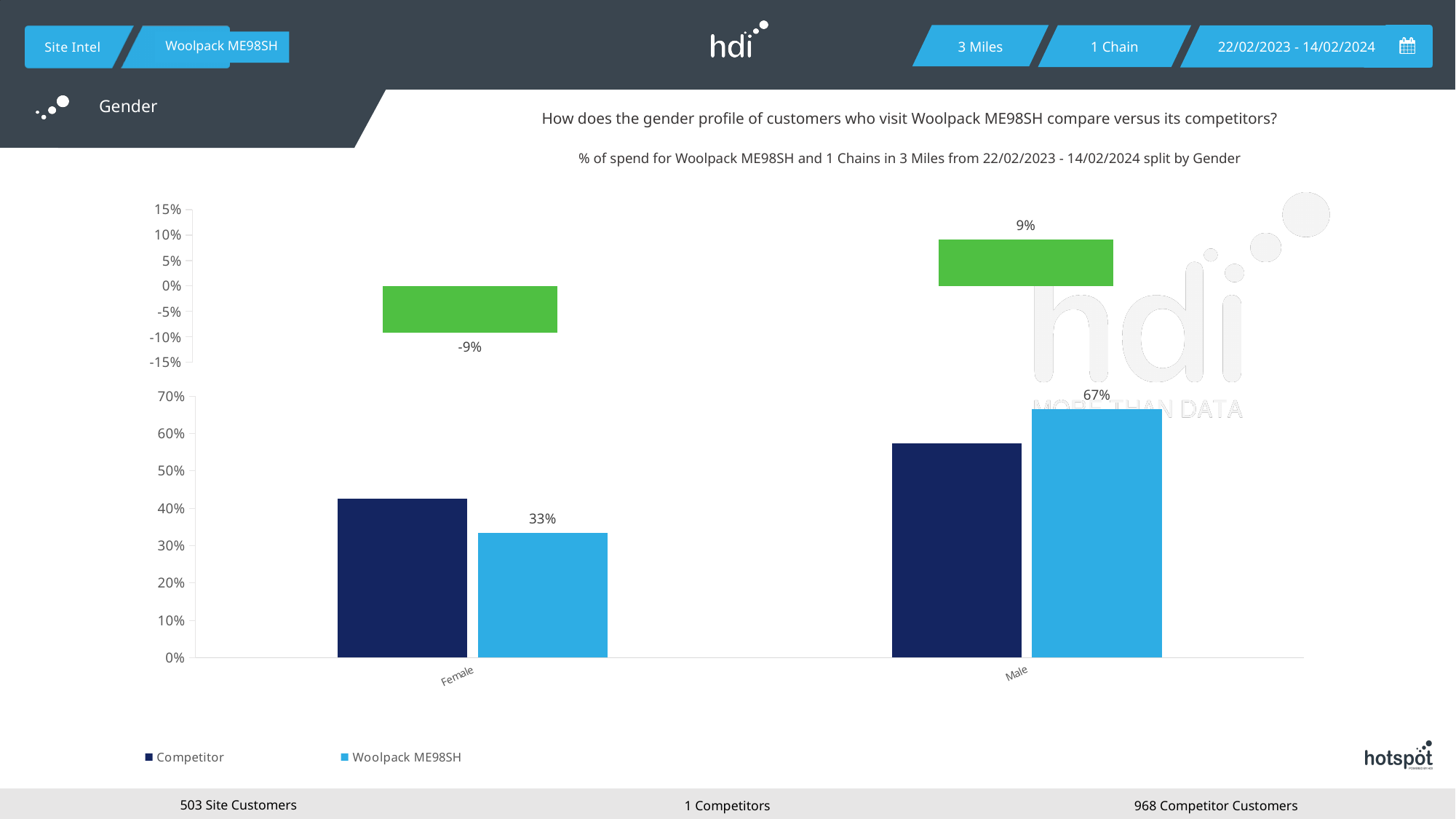
In the bottom chart, for Female, is the Competitor bar or the Woolpack ME98SH bar taller? Competitor In the top chart, what is the value shown for Male? 9% How many gender categories are shown on the x axis of the bottom chart? 2 How many series does the legend of the bottom chart list? 2 In the bottom chart, is the Competitor value for Female greater or less than 50%? less In the bottom chart, what is the % of spend for Woolpack ME98SH for Female? 33% What type of chart is the bottom chart? Bar chart In the bottom chart, what is the % of spend for Woolpack ME98SH for Male? 67% In the bottom chart, which gender has the higher % of spend for Woolpack ME98SH? Male In the bottom chart, is the Competitor value for Male greater or less than 50%? greater In the bottom chart, what is the difference between the Woolpack ME98SH values for Male and Female? 34% In the top chart, what is the value shown for Female? -9%